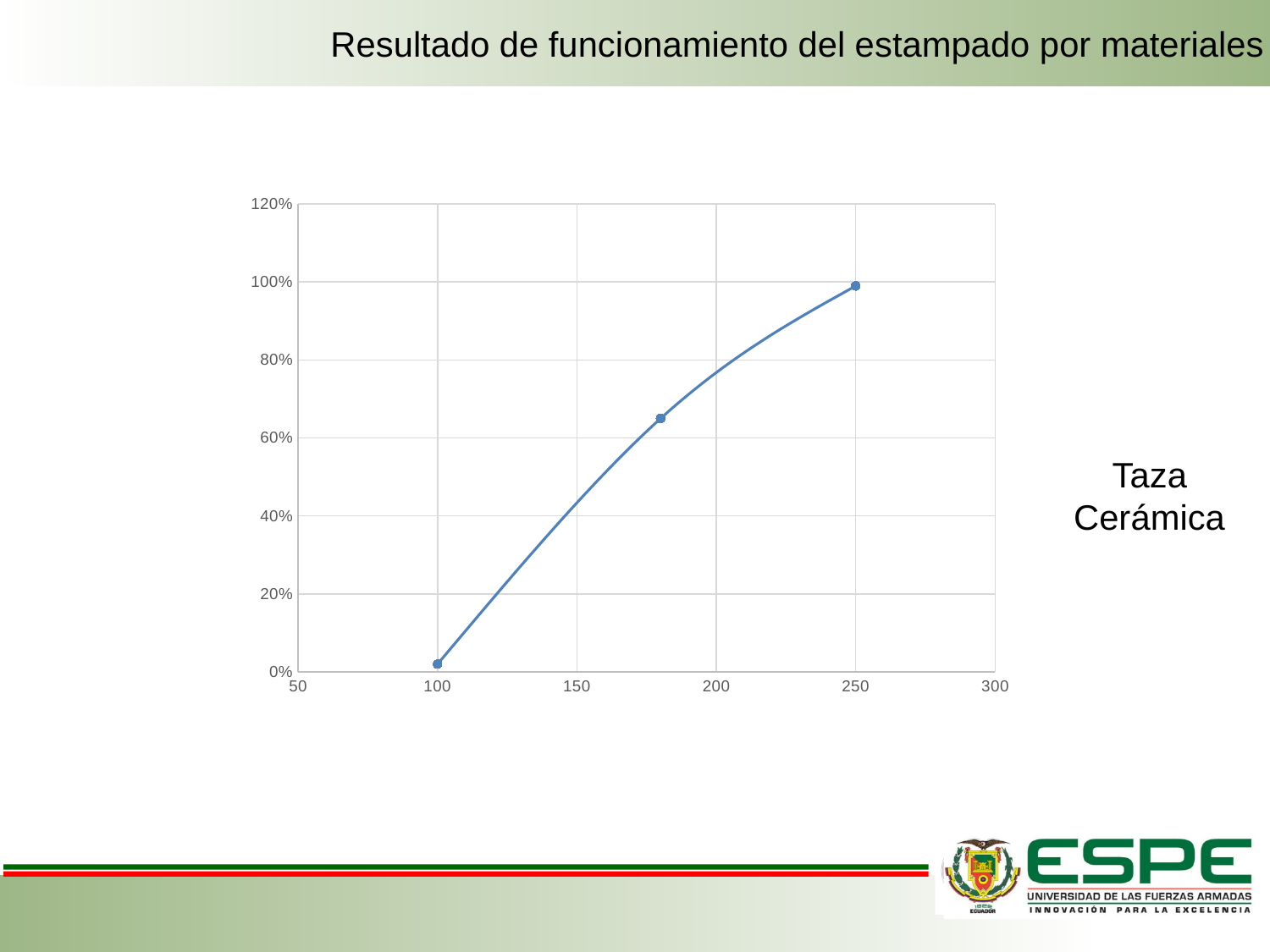
Is the value at x = 180 greater or less than 60%? greater Is the value at x = 100 greater or less than 20%? less At which x-axis value is the plotted value highest? 250 What kind of chart is shown on the slide? line chart Do the plotted values rise or fall as the x-axis value increases from 100 to 250? rise What is the highest value shown on the y-axis? 120% Is the value at x = 180 greater or less than 80%? less At which x-axis value is the plotted value lowest? 100 Which has the larger plotted value, x = 180 or x = 100? 180 How many data points are plotted on the chart? 3 What material label appears to the right of the chart? Taza Cerámica